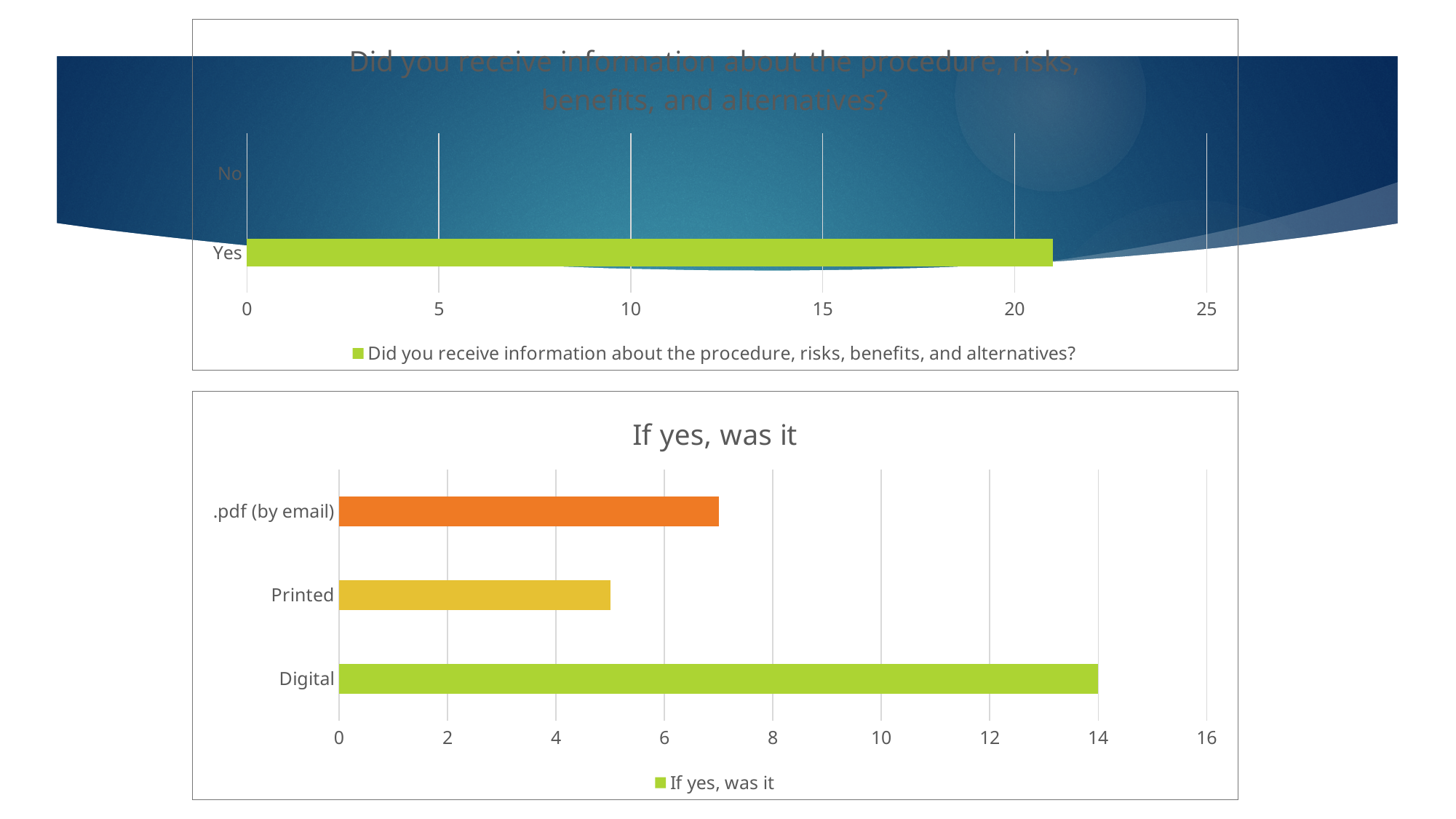
In the bottom chart titled "If yes, was it", which is larger, the value for .pdf (by email) or the value for Printed? .pdf (by email) How many categories are shown in the top chart? 2 In the bottom chart titled "If yes, was it", is the value for .pdf (by email) greater or less than 6? greater What kind of chart is the bottom chart titled "If yes, was it"? bar chart What is the title of the bottom chart? If yes, was it In the top chart, is the value for Yes greater or less than 20? greater How many categories are shown in the bottom chart titled "If yes, was it"? 3 In the bottom chart titled "If yes, was it", which category has the highest value? Digital In the bottom chart titled "If yes, was it", which category has the lowest value? Printed In the top chart, which category has the higher value, Yes or No? Yes In the bottom chart titled "If yes, was it", is the value for Printed greater or less than 6? less In the bottom chart titled "If yes, was it", what is the value for Digital? 14